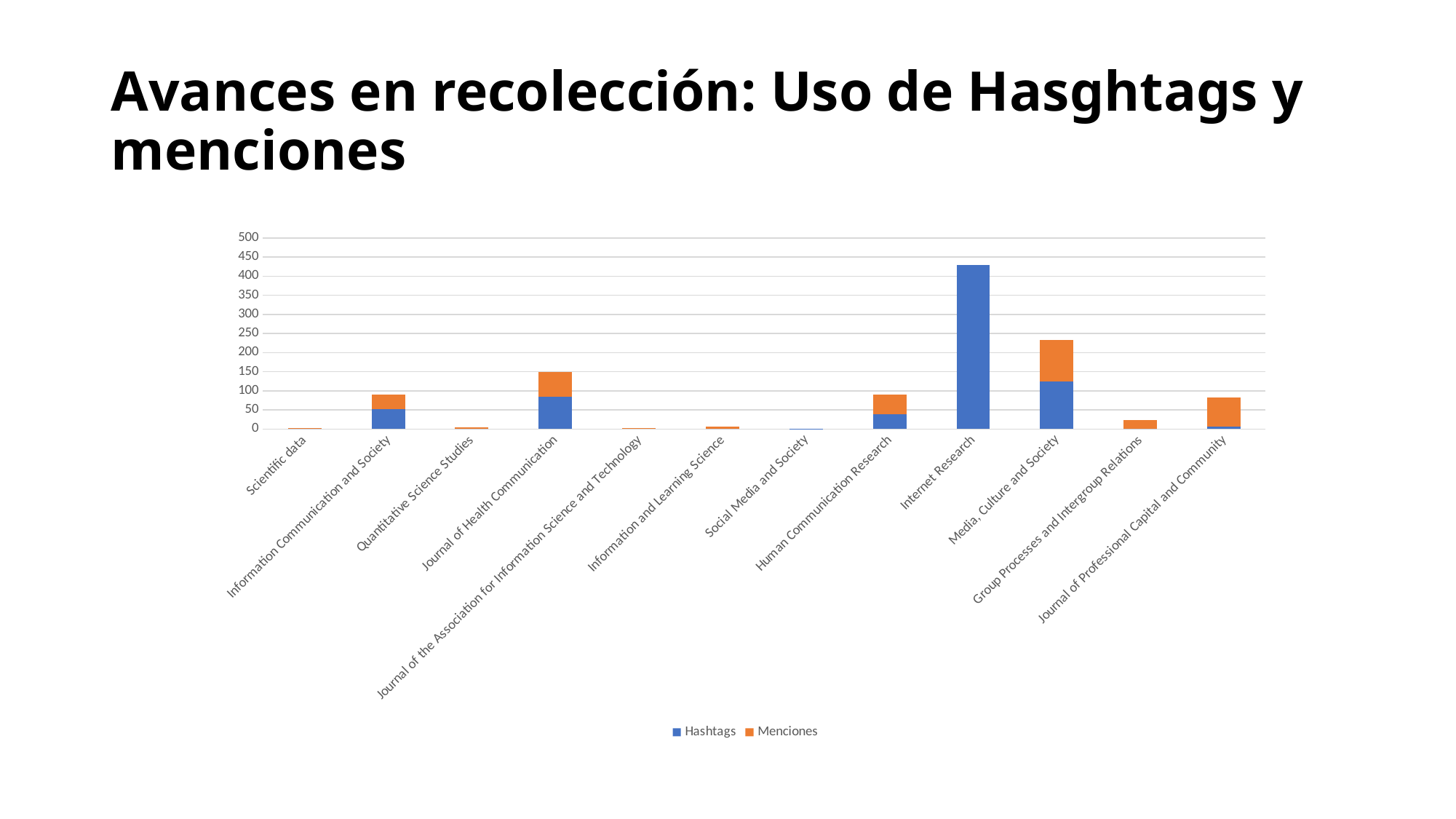
Which has the taller bar: Internet Research or Media, Culture and Society? Internet Research Is the total bar for Group Processes and Intergroup Relations greater or less than 50? less How many series does the chart's legend list? 2 Is the total bar for Media, Culture and Society greater or less than 200? greater What kind of chart is shown on the slide? Stacked bar chart Which category has the tallest bar in the chart? Internet Research Is the total bar for Journal of Professional Capital and Community greater or less than 100? less Which has the taller bar: Journal of Health Communication or Information Communication and Society? Journal of Health Communication How many journal categories are shown on the x axis of the chart? 12 Which series is shown in orange in the chart's legend? Menciones